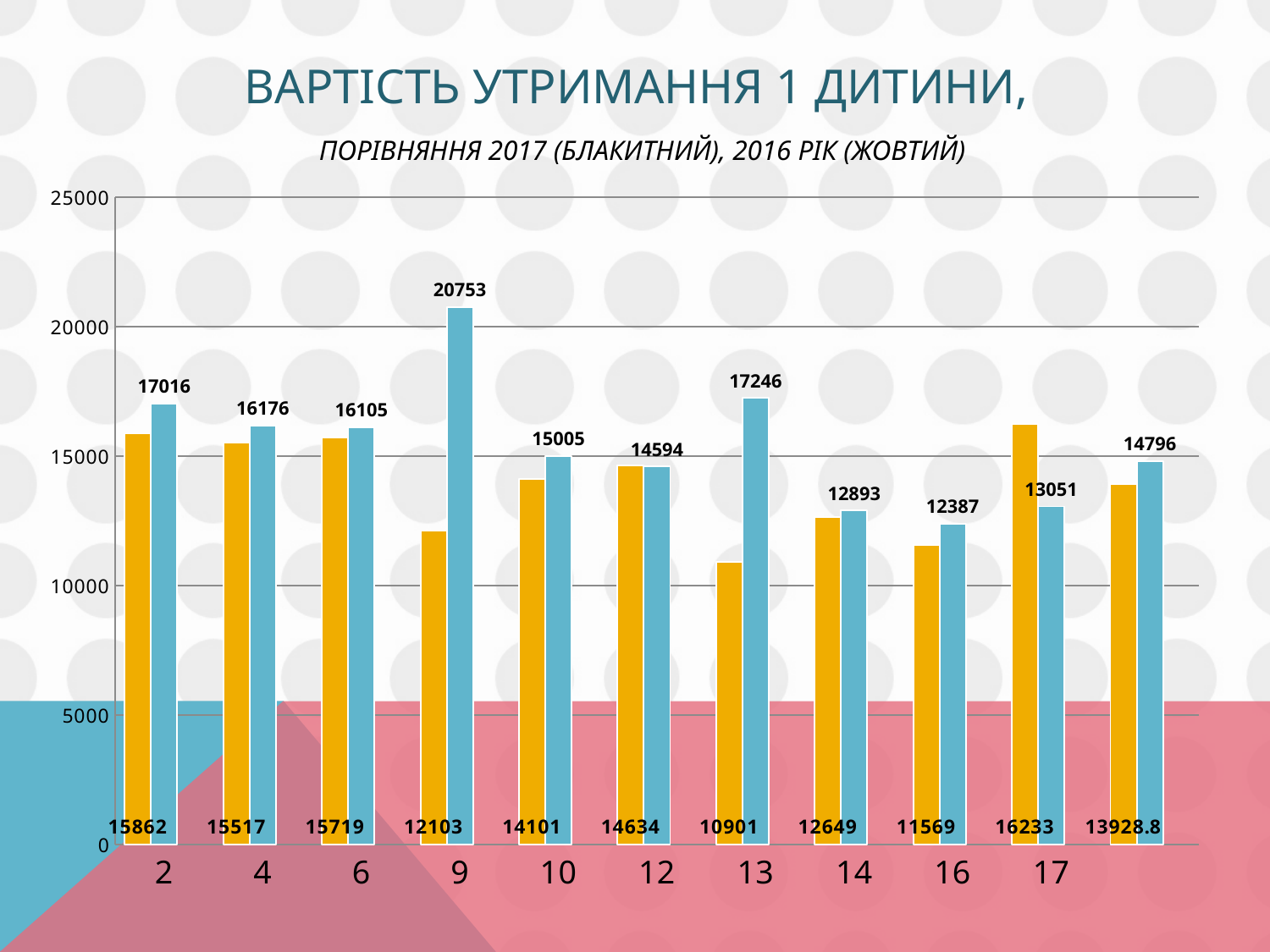
What is the 2017 (blue) value for category 9? 20753 For category 13, what is the difference between the 2017 (blue) value and the 2016 (yellow) value? 6345 For category 17, which is larger: the 2016 (yellow) value or the 2017 (blue) value? 2016 (yellow) What is the 2016 (yellow) value for category 17? 16233 Which category has the lowest 2016 (yellow) value? 13 How many categories (pairs of bars) are plotted on the chart? 11 What kind of chart is shown on the slide? bar chart For category 9, what is the difference between the 2017 (blue) value and the 2016 (yellow) value? 8650 What is the 2016 (yellow) value for category 13? 10901 Which category has the highest 2017 (blue) value? 9 Is the 2017 (blue) value for category 9 greater or less than 20000? greater According to the subtitle, which colour represents the year 2017? blue (блакитний)